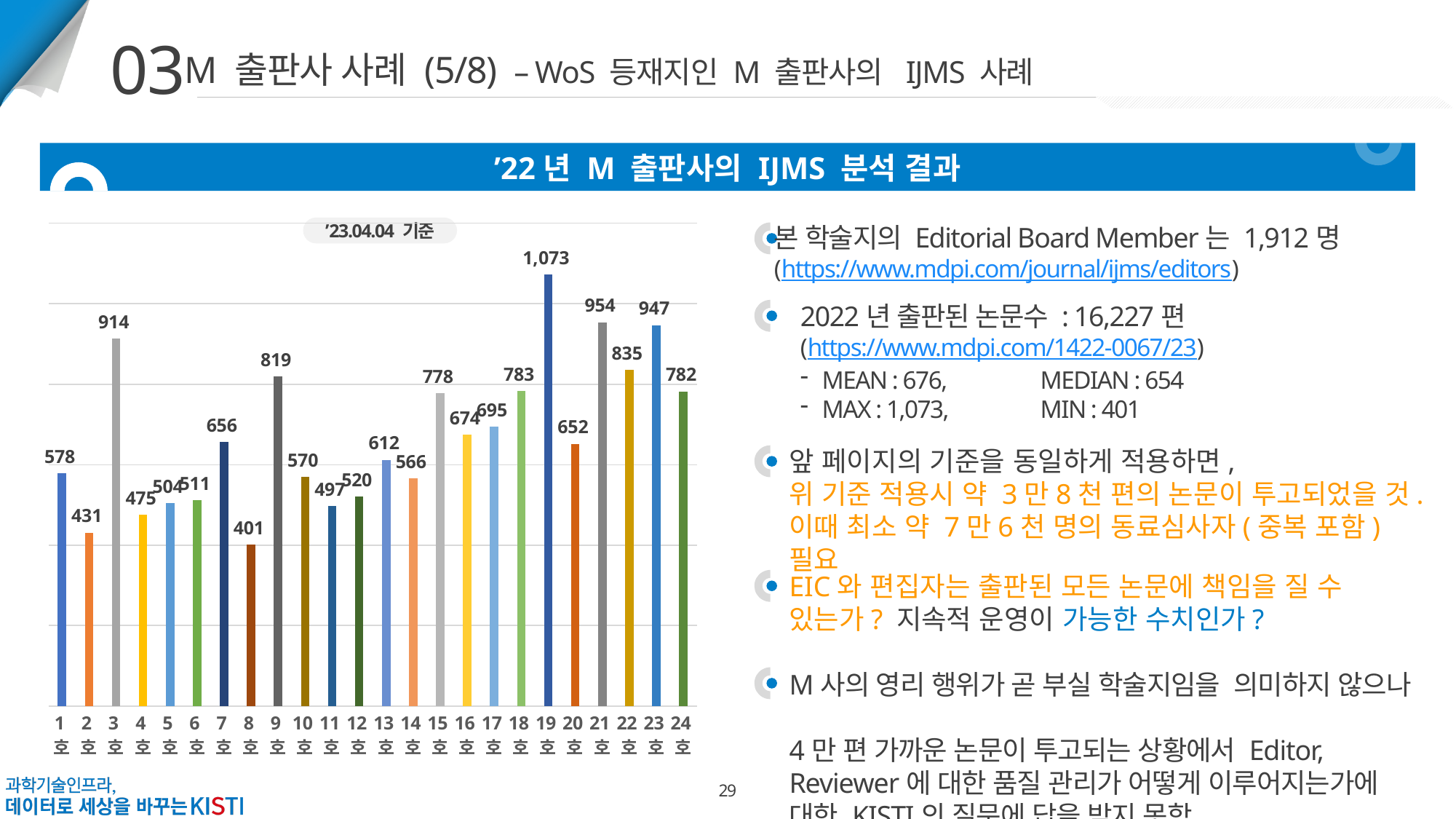
How many categories are shown on the x axis? 24 What is the value for 13호? 612 What is the difference between the values for 21호 and 20호? 302 Which category has the highest value? 19호 What is the difference between the values for 1호 and 2호? 147 What is the value for 8호? 401 What kind of chart is shown on the slide? bar chart Which category has the lowest value? 8호 Which is larger, the value for 9호 or the value for 15호? 9호 What is the value for 19호? 1,073 What date label is shown above the chart? '23.04.04 기준 What is the value for 3호? 914